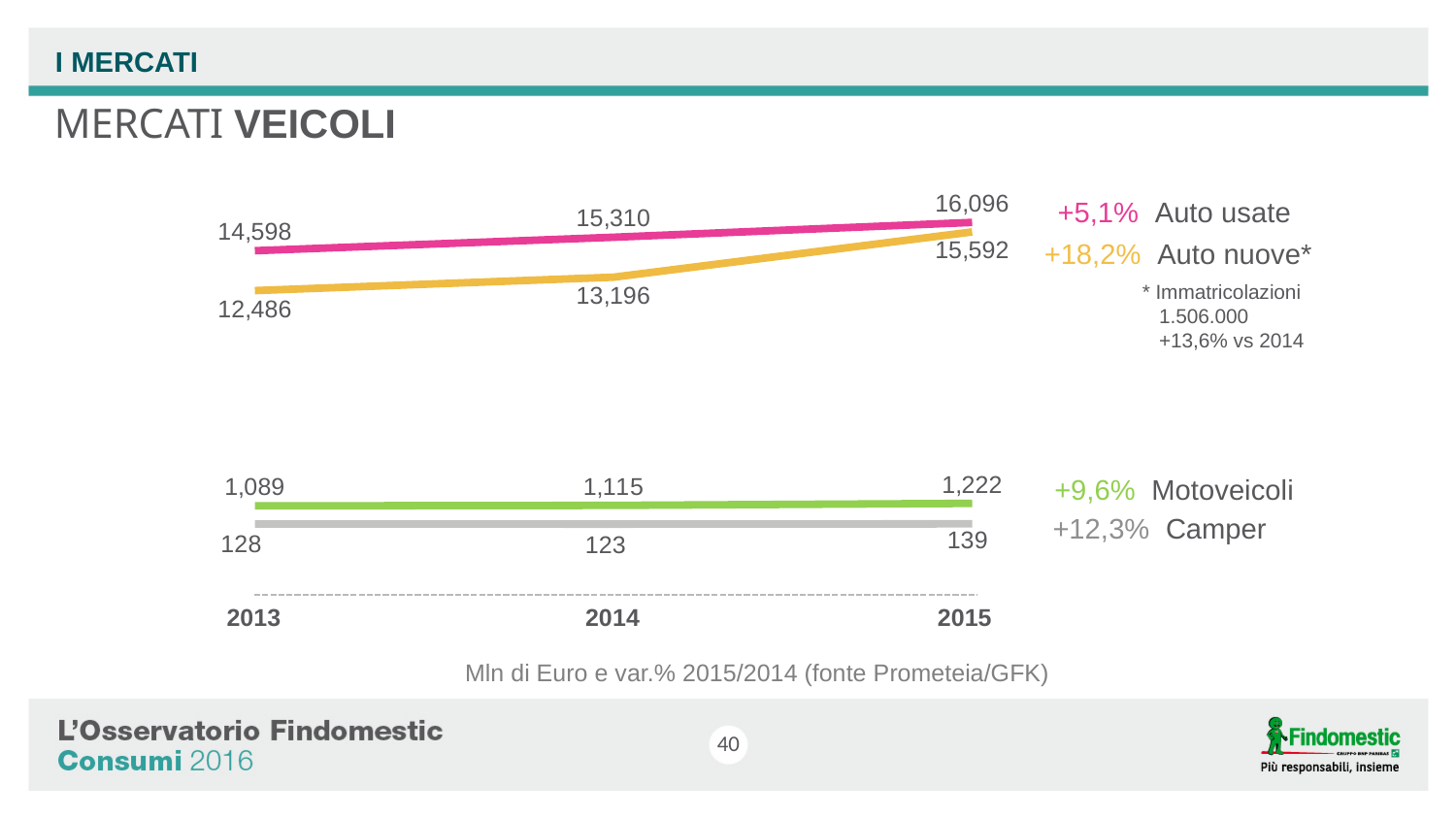
In the bottom chart, in which year is Camper lowest? 2014 In the top chart, does the value for Auto usate rise or fall from 2013 to 2015? Rise In the bottom chart, what is the value for Motoveicoli in 2015? 1,222 What percentage change is shown next to Auto nuove in the top chart? +18,2% How many years are shown on the x axis of the charts? 3 What kind of chart is the top chart? Line chart In the top chart, what is the difference between Auto usate and Auto nuove in 2014? 2,114 In the top chart, in which year is Auto nuove highest? 2015 In the bottom chart, which is larger in 2013: Motoveicoli or Camper? Motoveicoli In the top chart, what is the value for Auto nuove in 2013? 12,486 In the bottom chart, what is the value for Camper in 2014? 123 In the top chart, what is the value for Auto usate in 2015? 16,096